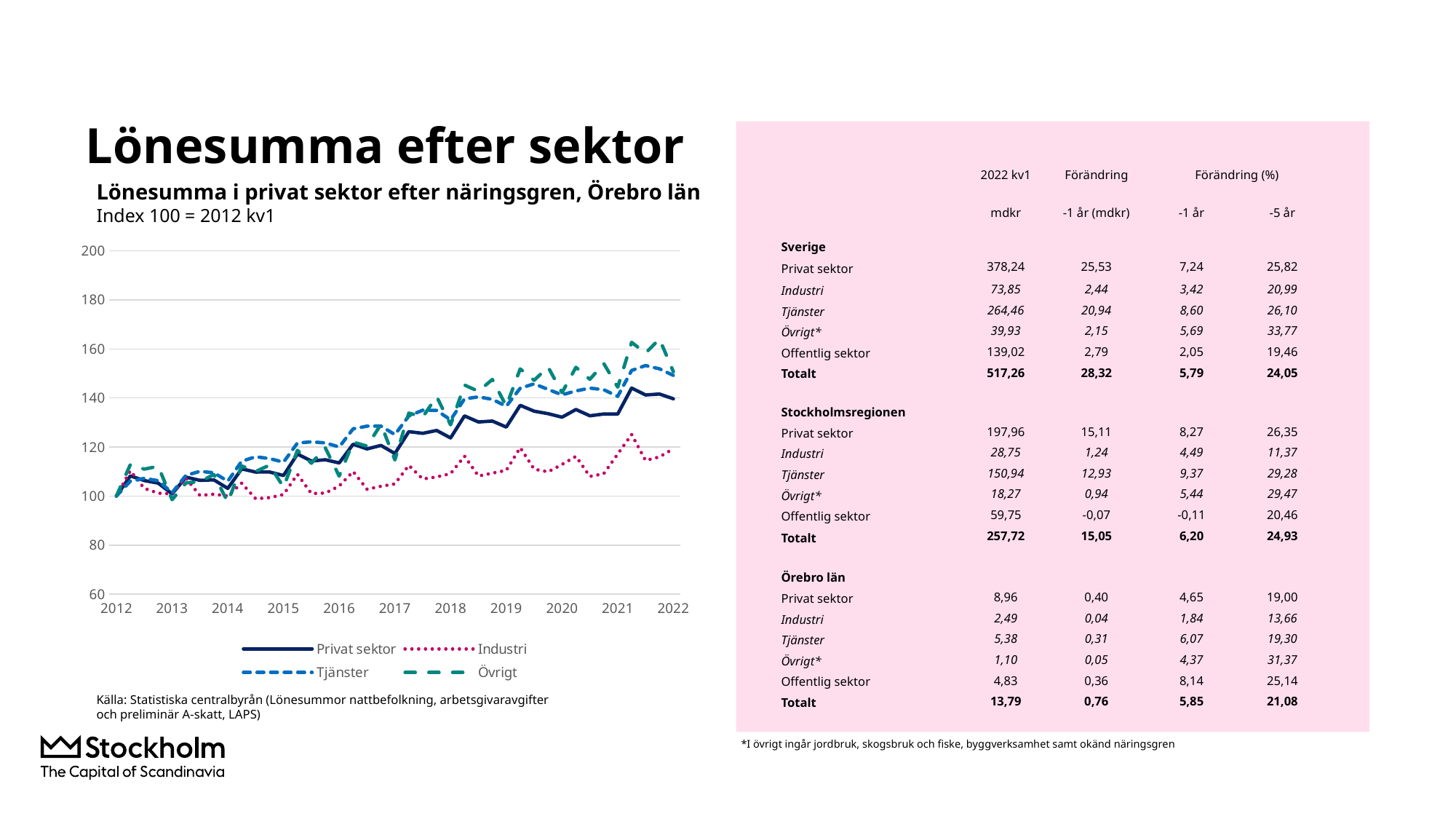
How many series does the chart legend list? 4 Which series has the lowest index value at the end of the chart in 2022? Industri Is the Tjänster index value in 2022 greater or less than 140? greater At the end of the chart in 2022, which is larger: Tjänster or Industri? Tjänster Is the Industri index value in 2022 greater or less than 140? less What is the title of the chart? Lönesumma i privat sektor efter näringsgren, Örebro län How many year labels are shown on the x axis of the chart? 11 Does the Privat sektor index rise or fall from 2012 to 2022? rise What kind of chart is shown on the slide? line chart Which series are listed in the chart legend? Privat sektor, Industri, Tjänster, Övrigt Is the Privat sektor index value in 2022 greater or less than 120? greater